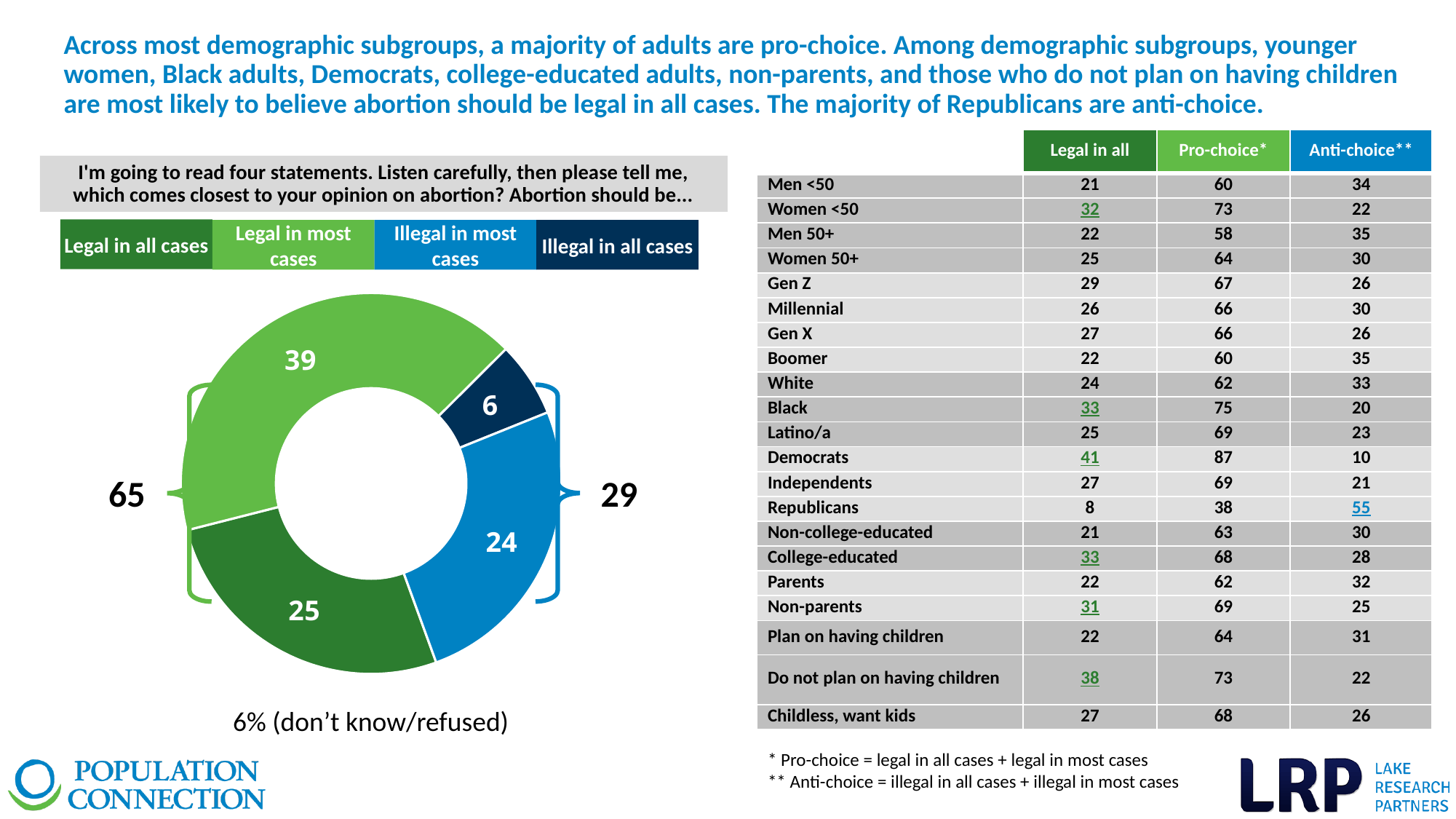
Which segment of the donut chart has the smallest value? Illegal in all cases In the donut chart, what is the difference between the "Legal in most cases" value and the "Illegal in all cases" value? 33 Which segment of the donut chart has the largest value? Legal in most cases What kind of chart is shown on the left of the slide? Donut (pie) chart In the donut chart, what value is shown for "Legal in all cases"? 25 What combined value does the bracket on the left side of the donut chart show for the two "legal" segments? 65 What percentage is listed below the donut chart as don't know/refused? 6% In the donut chart, what value is shown for "Legal in most cases"? 39 How many segments does the donut chart have? 4 In the donut chart, what value is shown for "Illegal in all cases"? 6 In the donut chart, which is larger: "Legal in all cases" or "Illegal in most cases"? Legal in all cases In the donut chart, what value is shown for "Illegal in most cases"? 24